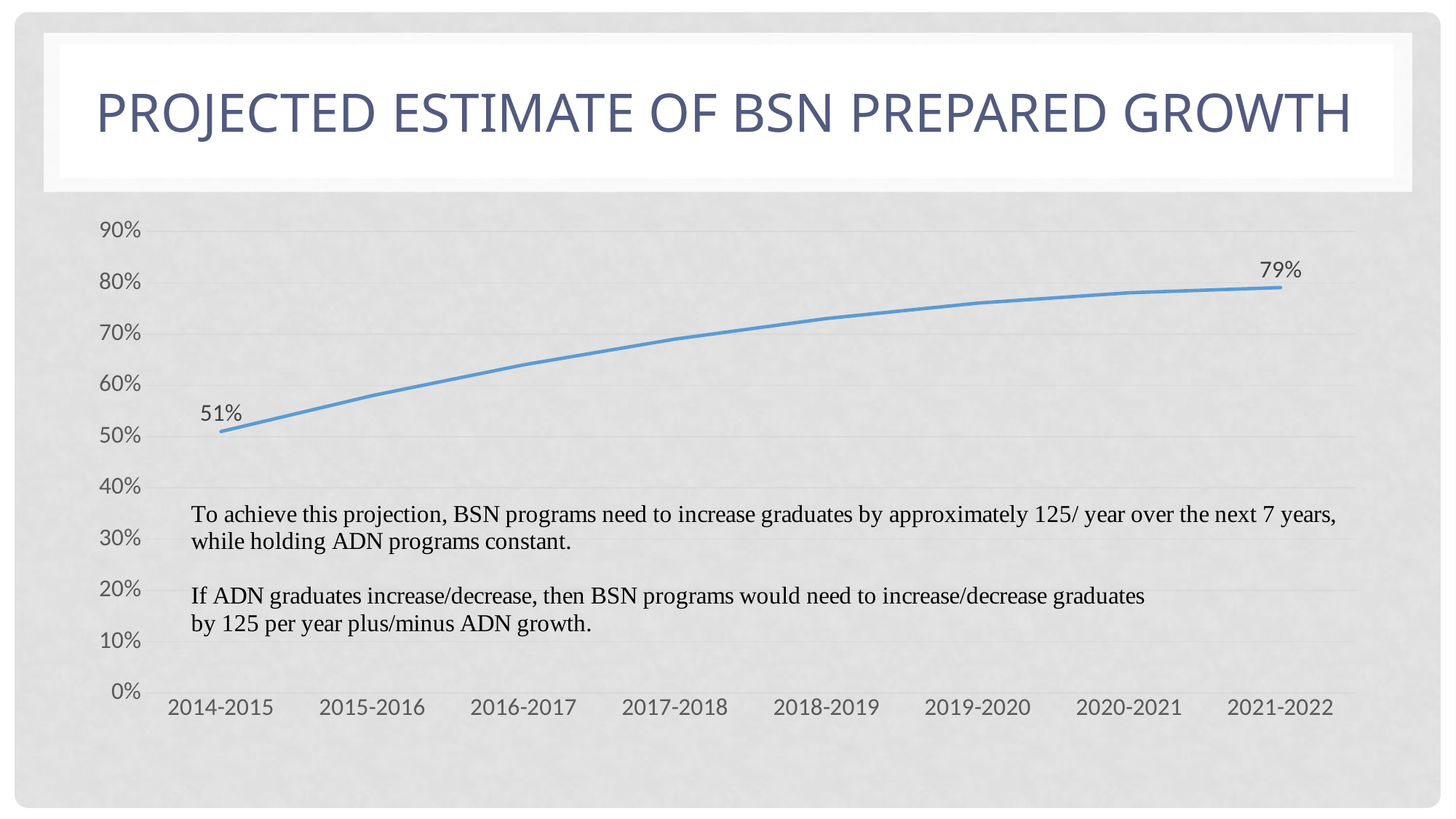
Is the value for 2017-2018 greater or less than 60%? greater Which is larger, the value for 2014-2015 or the value for 2021-2022? 2021-2022 Which year has the highest value? 2021-2022 Is the value for 2018-2019 greater or less than 80%? less What is the difference between the values for 2021-2022 and 2014-2015? 28% Which year has the lowest value? 2014-2015 Is the value for 2019-2020 greater or less than 70%? greater What kind of chart is shown on the slide? line chart How many academic years are shown on the x axis? 8 What is the value for 2021-2022? 79% Do the values rise or fall from 2014-2015 to 2021-2022? rise What is the value for 2014-2015? 51%